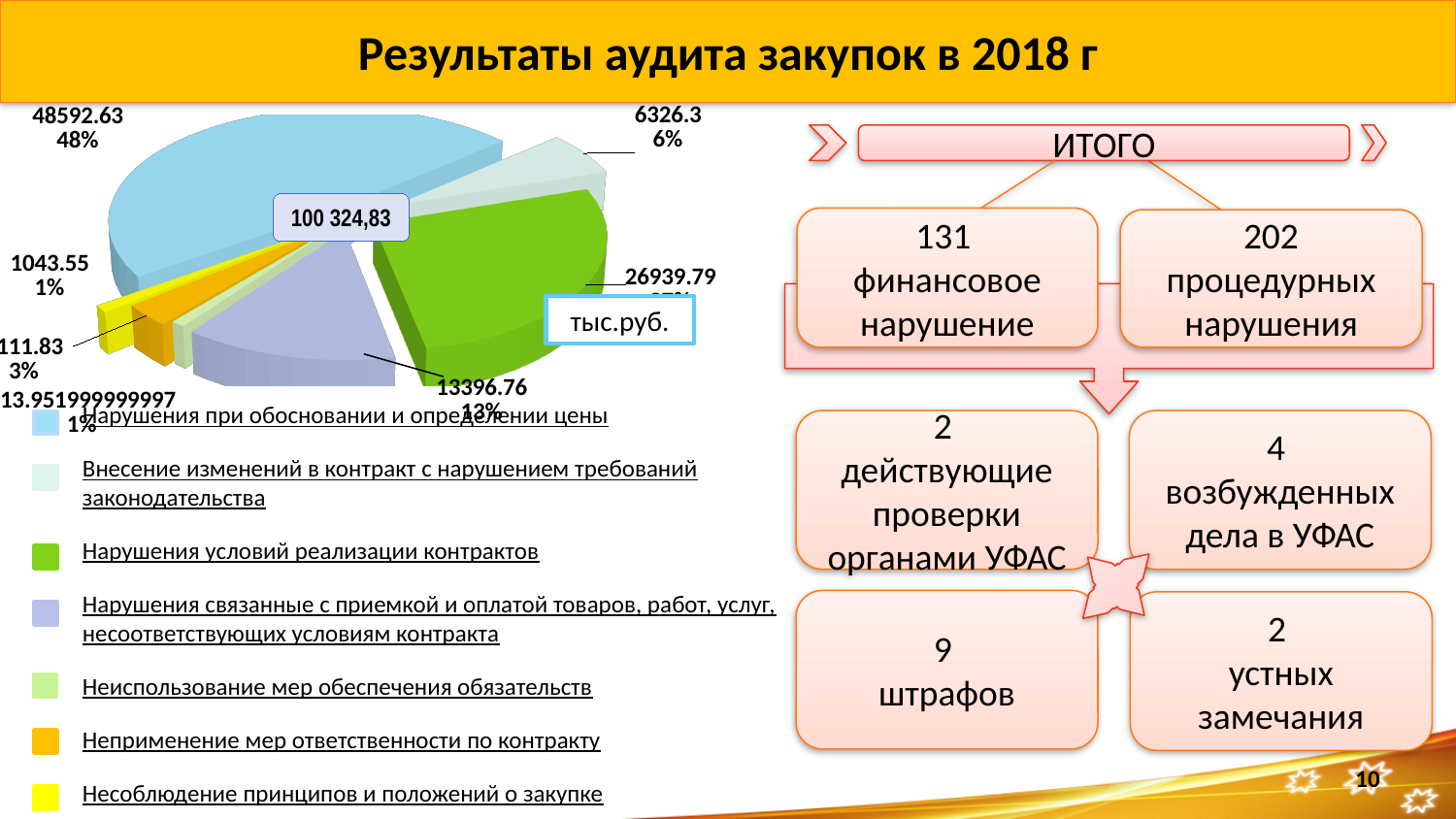
What is the value shown for 'Нарушения при обосновании и определении цены'? 48592.63 Which category has the largest slice in the pie chart? Нарушения при обосновании и определении цены Which is larger: the value for 'Нарушения связанные с приемкой и оплатой товаров, работ, услуг, несоответствующих условиям контракта' or for 'Внесение изменений в контракт с нарушением требований законодательства'? Нарушения связанные с приемкой и оплатой товаров, работ, услуг, несоответствующих условиям контракта What share of the pie does 'Нарушения при обосновании и определении цены' have? 48% What share of the pie does 'Нарушения связанные с приемкой и оплатой товаров, работ, услуг, несоответствующих условиям контракта' have? 13% What is the value shown for 'Внесение изменений в контракт с нарушением требований законодательства'? 6326.3 What kind of chart is shown on the slide? pie chart What total value is printed in the centre of the pie chart? 100 324,83 What is the value shown for 'Нарушения условий реализации контрактов'? 26939.79 What is the difference between the values for 'Нарушения при обосновании и определении цены' (48592.63) and 'Нарушения связанные с приемкой и оплатой товаров, работ, услуг, несоответствующих условиям контракта' (13396.76)? 35195.87 What unit is indicated for the values in the pie chart? тыс.руб. How many categories does the legend of the pie chart list? 7